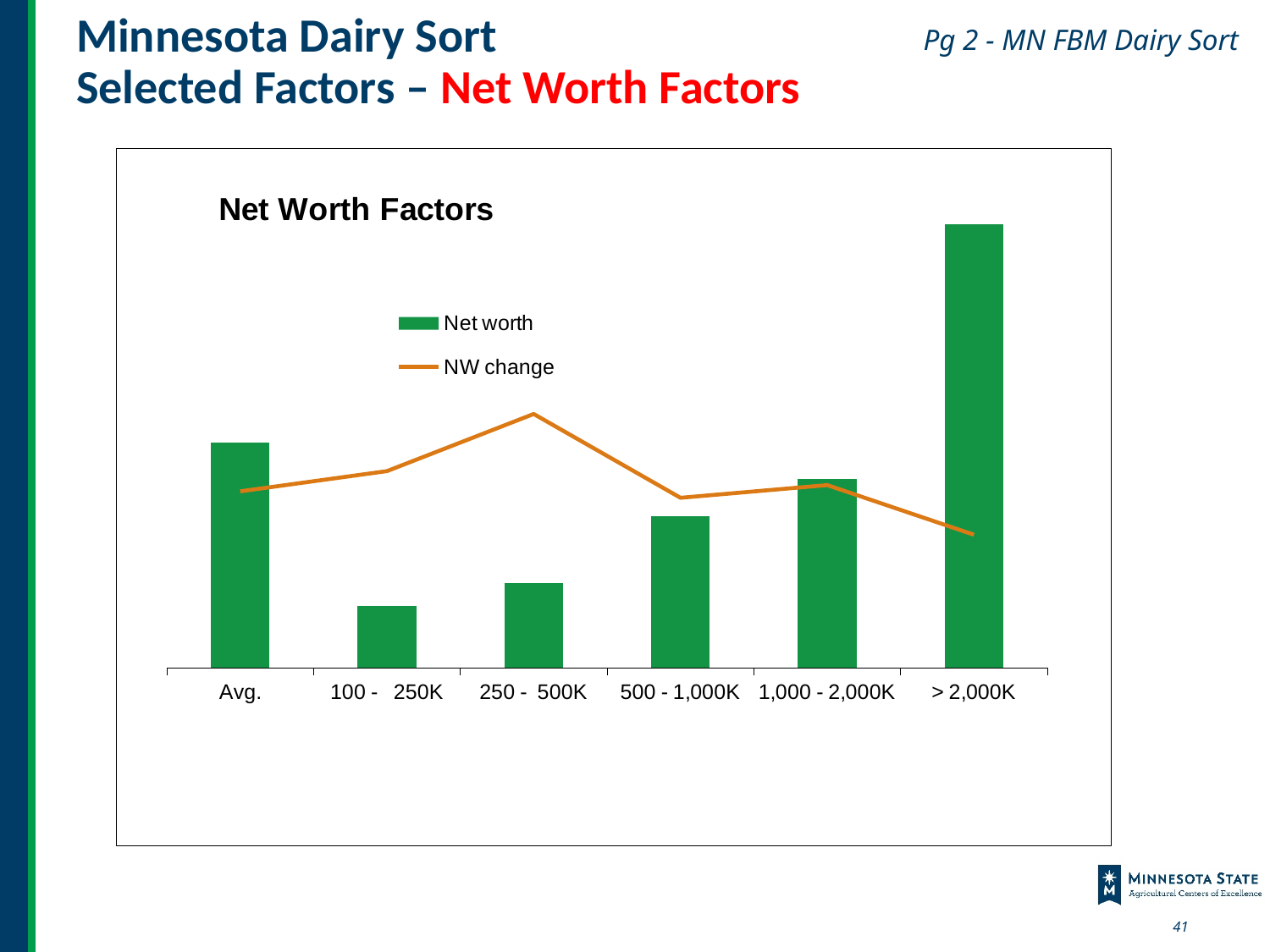
What colour are the Net worth bars? green What kind of chart is used to plot the Net worth series? bar chart Do the Net worth bars rise or fall moving from 100 - 250K to > 2,000K? rise Which category has the lowest Net worth bar? 100 - 250K What kind of chart is used to plot the NW change series? line chart How many categories are shown on the x axis of the chart? 6 Which has the larger Net worth bar, Avg. or 1,000 - 2,000K? Avg. Which category has the highest Net worth bar? > 2,000K How many series does the chart legend list? 2 At which category does the NW change line reach its highest point? 250 - 500K At which category does the NW change line reach its lowest point? > 2,000K What is the title of the chart? Net Worth Factors